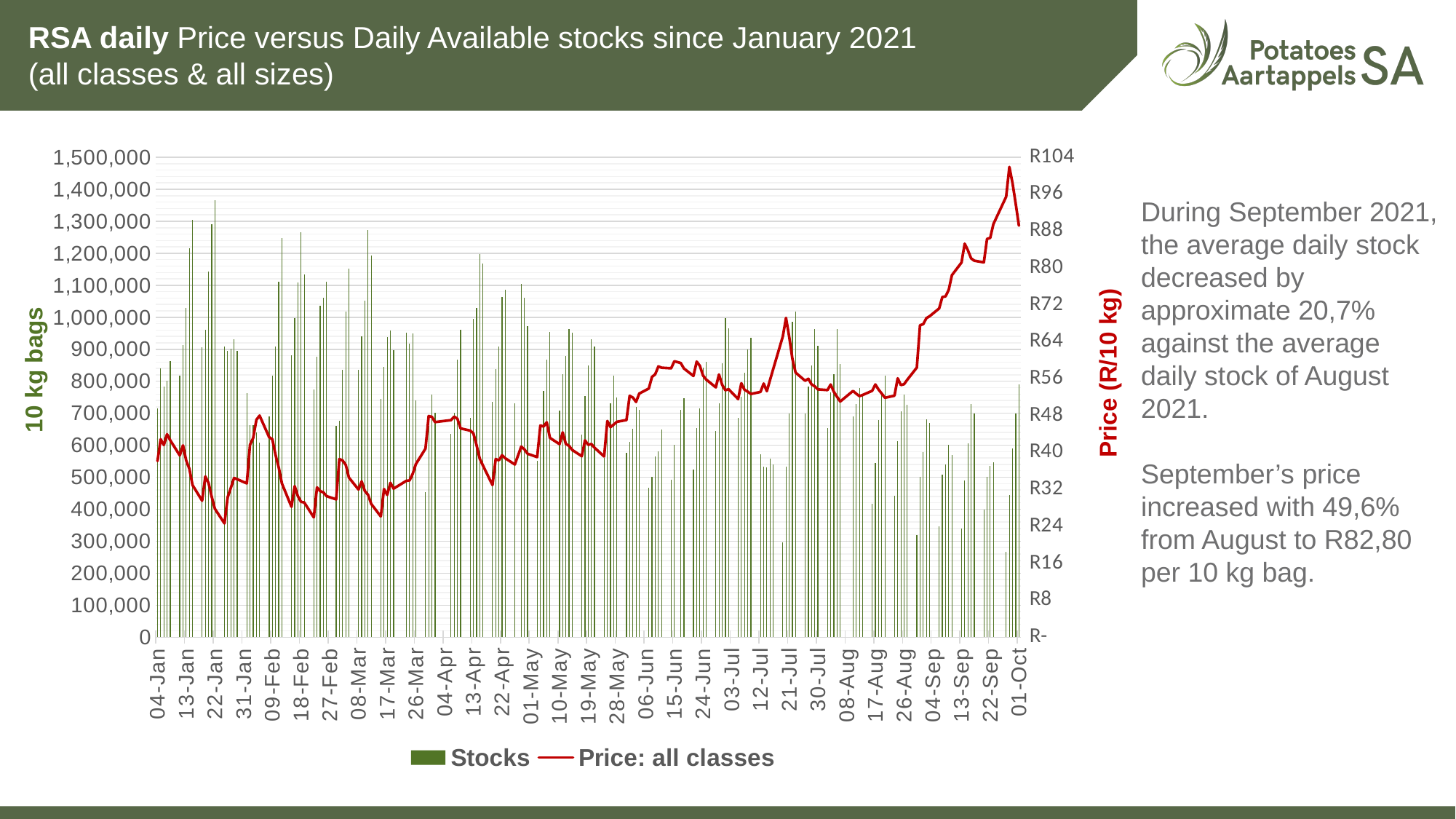
Is the price for all classes at 01-Oct greater or less than R80? greater What kind of chart is shown on the slide? Combined bar and line chart What is the title of the right-hand vertical axis of the chart? Price (R/10 kg) Does the price for all classes rise or fall between 13-Jan and 22-Jan? fall Is the price for all classes at 04-Jan greater or less than R48? less How many series does the chart legend list? 2 In which month does the price line reach its lowest value? January In which month does the price line reach its highest value? September Is the highest point of the price line greater or less than R96? greater Does the price for all classes rise or fall between 26-Aug and 22-Sep? rise What are the two series named in the chart legend? Stocks and Price: all classes